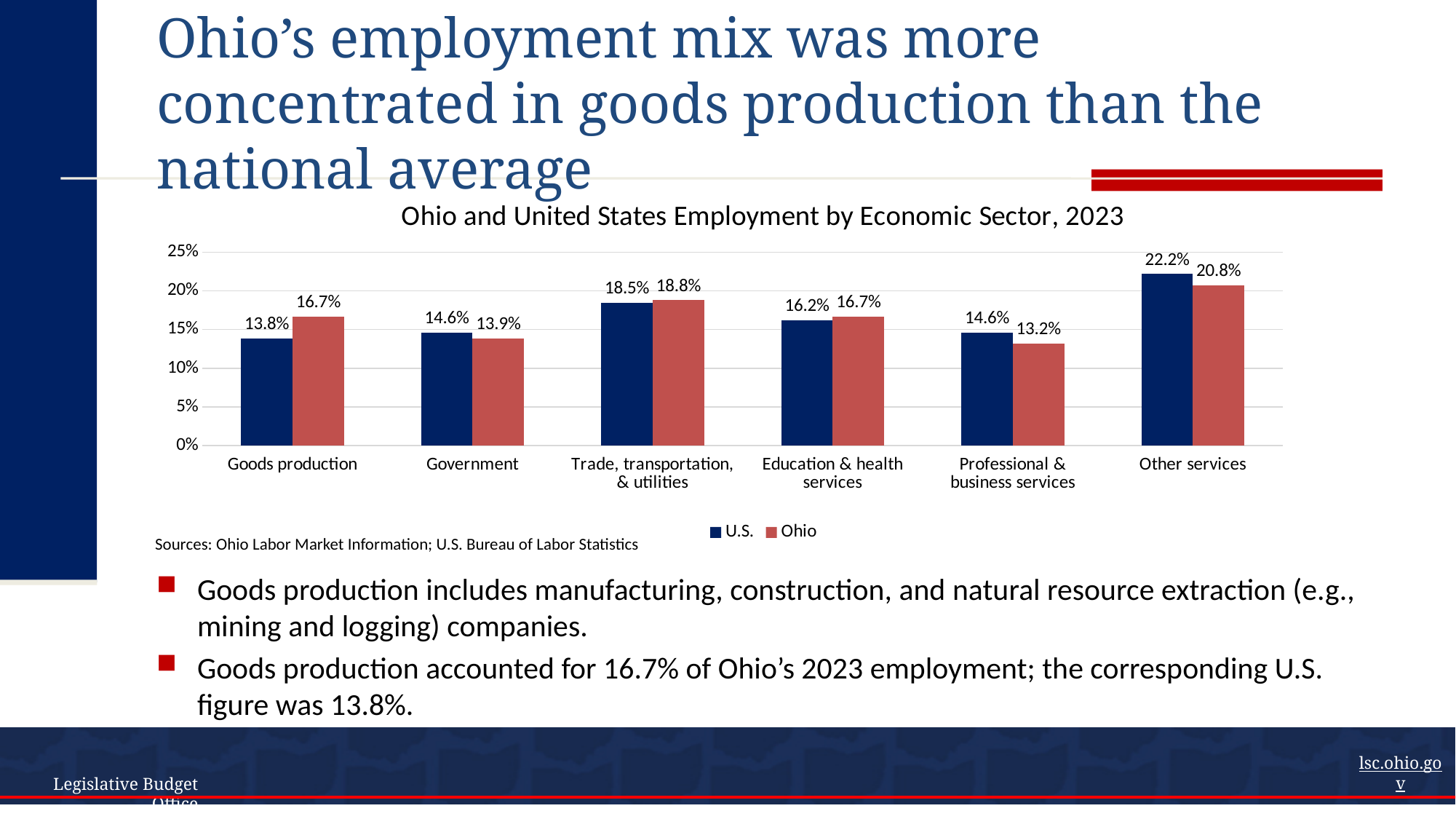
How many series does the legend list? 2 What is the U.S. value for Professional & business services? 14.6% What is the Ohio value for Other services? 20.8% Which sector has the lowest Ohio value? Professional & business services What is the Ohio value for Goods production? 16.7% What is the difference between the Ohio and U.S. values for Goods production? 2.9% Which is larger for Government, the U.S. value or the Ohio value? U.S. How many economic sectors are shown on the x axis? 6 Is the U.S. value for Trade, transportation, & utilities greater or less than 15%? greater Which sector has the highest U.S. value? Other services What is the title of the chart? Ohio and United States Employment by Economic Sector, 2023 What kind of chart is shown on the slide? Bar chart